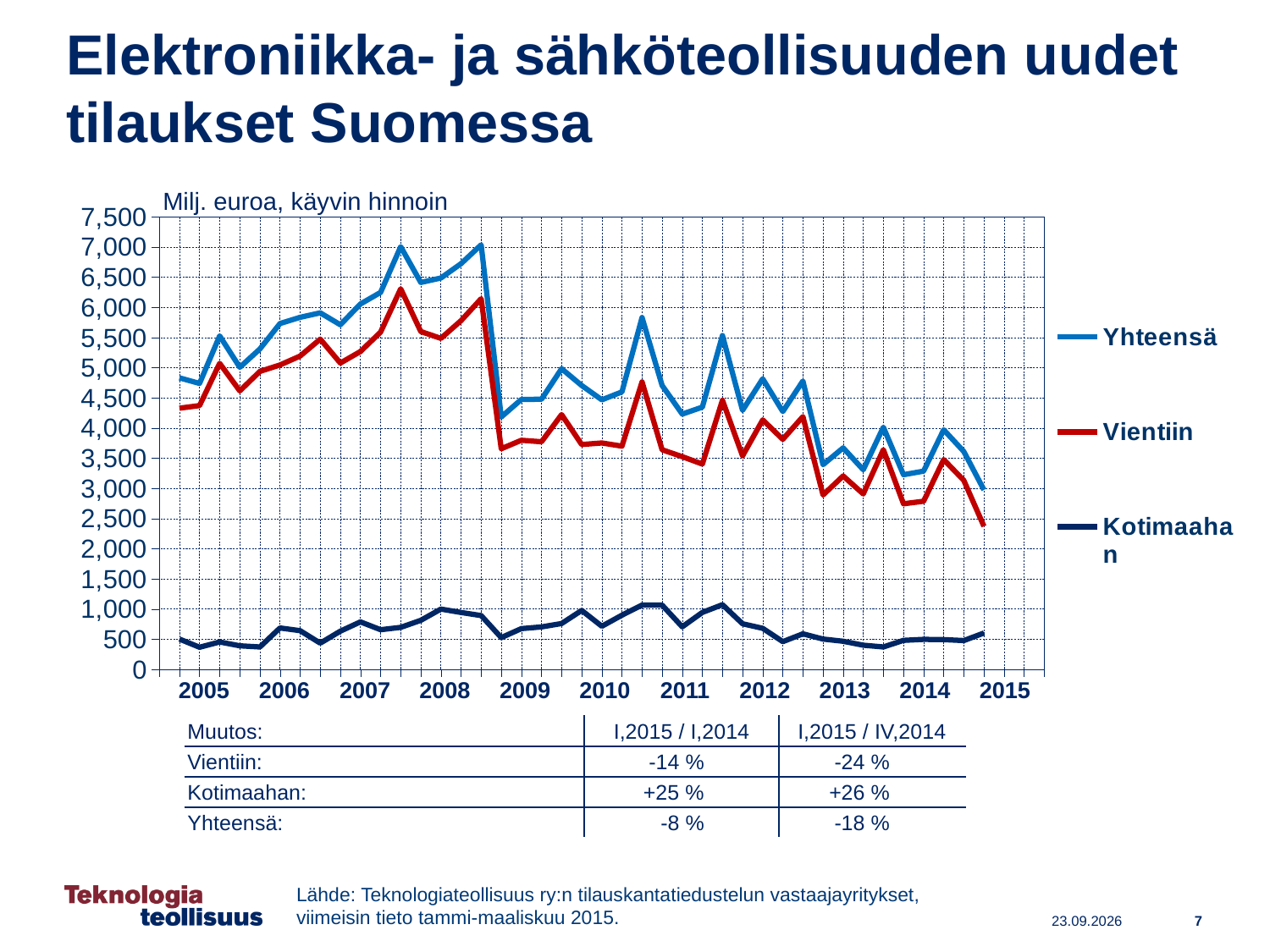
Is the value for Kotimaahan ever greater or less than 1,500 over the whole period? less How many series does the chart legend list? 3 What kind of chart is shown on the slide? line chart Is the value for Yhteensä at its 2008 peak greater or less than 6,500? greater Is the value for Yhteensä at the start of 2005 greater or less than 4,500? greater What are the three series named in the chart legend? Yhteensä, Vientiin, Kotimaahan Does the Vientiin series generally rise or fall between 2008 and 2015? fall Does the Yhteensä series generally rise or fall between 2005 and 2008? rise Which series has the lowest values throughout the chart? Kotimaahan What unit label is shown above the chart's y axis? Milj. euroa, käyvin hinnoin Which series has the highest values throughout the chart? Yhteensä